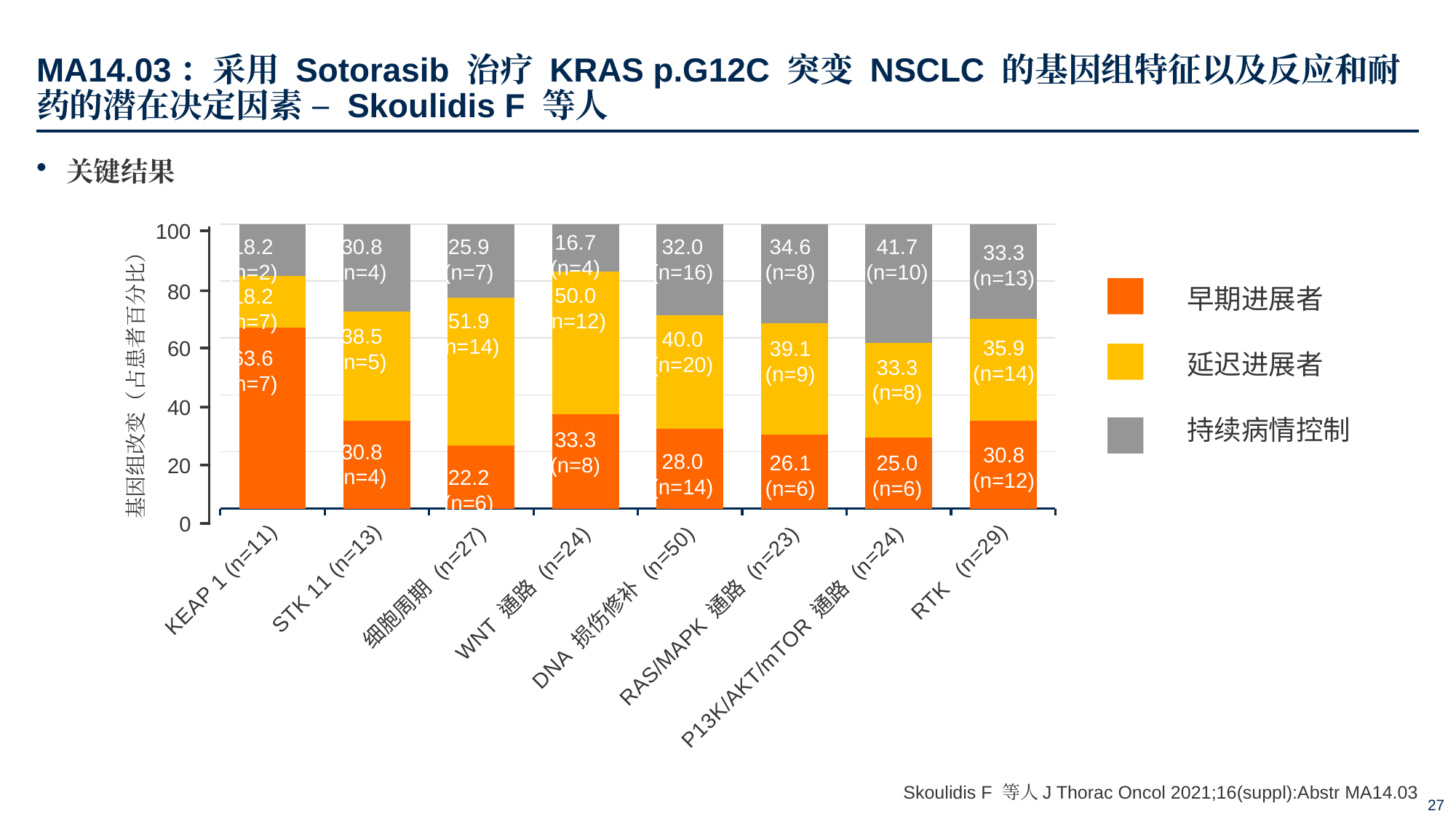
What kind of chart is shown on the slide? Stacked bar chart Which category has the highest 持续病情控制 value? P13K/AKT/mTOR 通路 (n=24) What is the 早期进展者 value for DNA 损伤修补 (n=50)? 28.0 What is the 延迟进展者 value for 细胞周期 (n=27)? 51.9 What is the difference between the 延迟进展者 values for WNT 通路 (n=24) and RTK (n=29)? 14.1 How many series does the legend list? 3 What is the total of the stacked bar for DNA 损伤修补 (n=50)? 100.0 Which is larger, the 早期进展者 value for STK 11 (n=13) or for RAS/MAPK 通路 (n=23)? STK 11 (n=13) Which category has the lowest 早期进展者 value? 细胞周期 (n=27) What is the 持续病情控制 value for P13K/AKT/mTOR 通路 (n=24)? 41.7 Which category has the lowest 持续病情控制 value? WNT 通路 (n=24) How many categories are shown on the x axis? 8